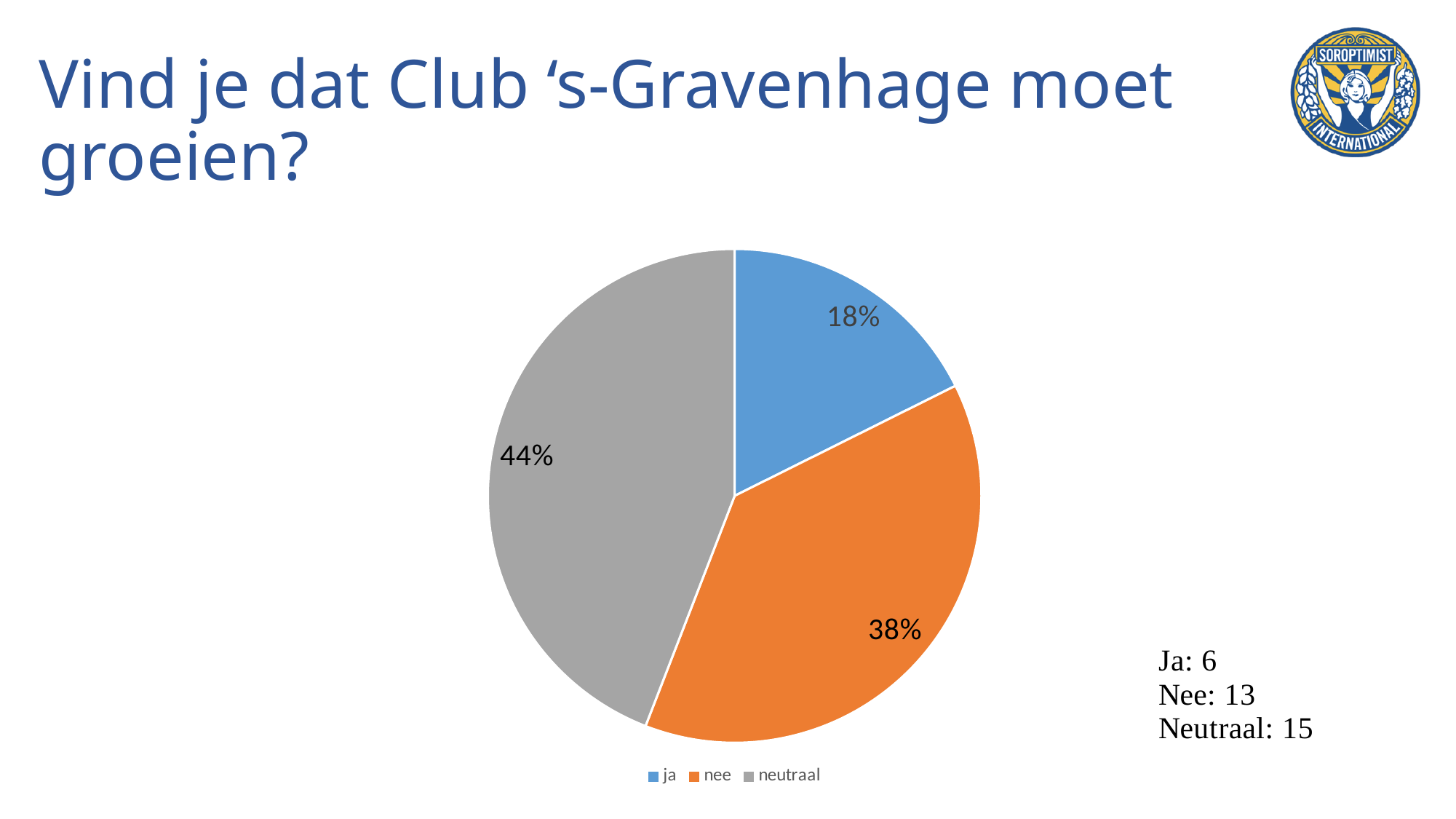
What share of the pie does the 'neutraal' slice represent? 44% How many entries does the legend list? 3 What share of the pie does the 'nee' slice represent? 38% Which category has the largest slice of the pie? neutraal What colour is the 'nee' slice in the pie chart? orange How many categories does the pie chart show? 3 What is the difference in percentage points between the 'neutraal' and 'ja' slices? 26 What kind of chart is shown on the slide? pie chart Which slice is larger, 'nee' or 'ja'? nee Is the share for 'neutraal' greater or less than 40%? greater What share of the pie does the 'ja' slice represent? 18% Which category has the smallest slice of the pie? ja